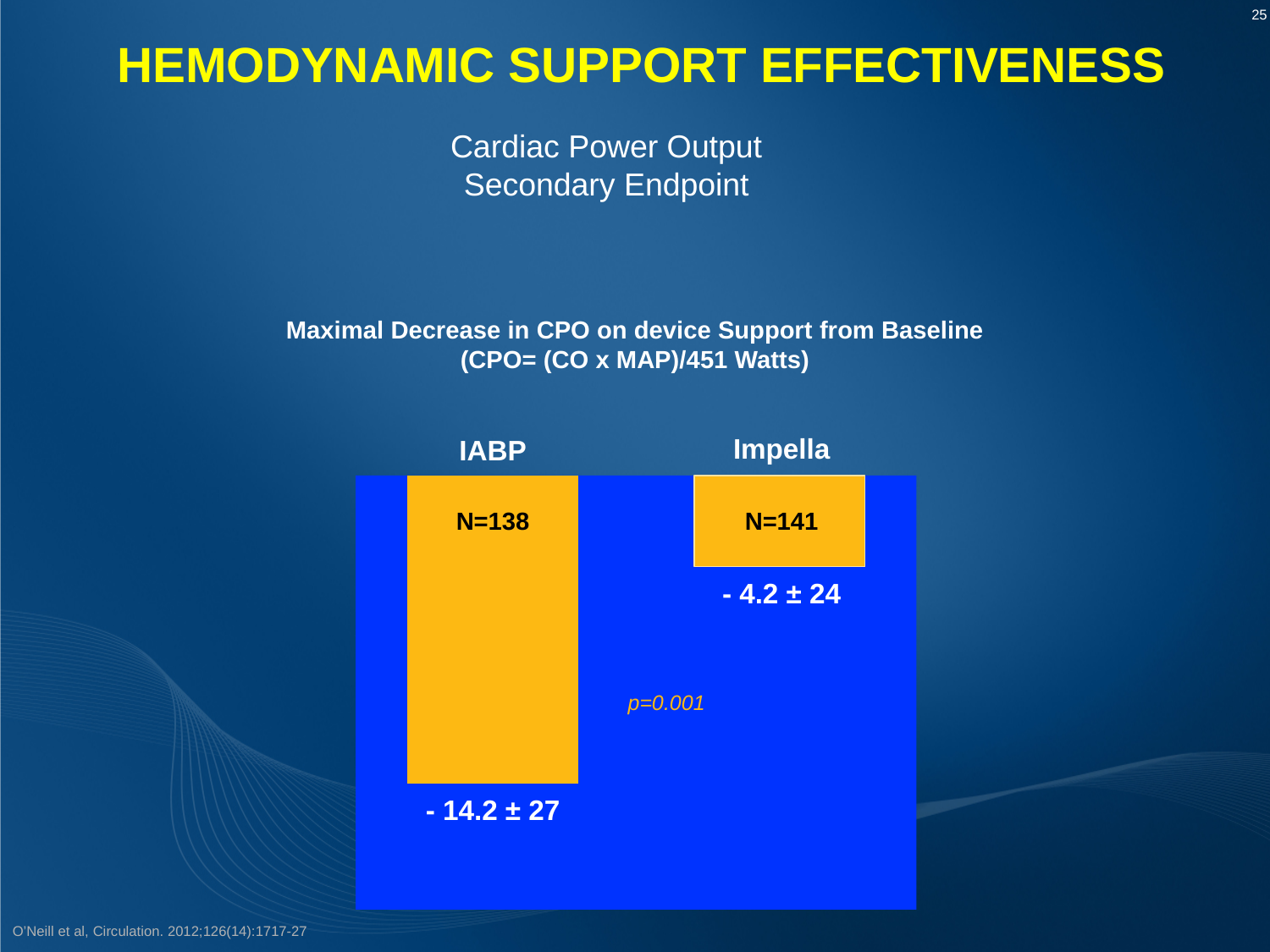
What kind of chart is shown on the slide? Bar chart Which device shows the smaller maximal decrease in CPO? Impella What is the title of the chart? Maximal Decrease in CPO on device Support from Baseline (CPO= (CO x MAP)/451 Watts) What is the N shown for the Impella group? N=141 What value is labelled on the Impella bar? - 4.2 ± 24 What value is labelled on the IABP bar? - 14.2 ± 27 What p-value is shown on the chart? p=0.001 Which bar is longer, IABP or Impella? IABP How many device groups are plotted on the chart? 2 By how much does the mean maximal decrease in CPO for IABP exceed that for Impella? 10 What is the N shown for the IABP group? N=138 Which device shows the larger maximal decrease in CPO? IABP